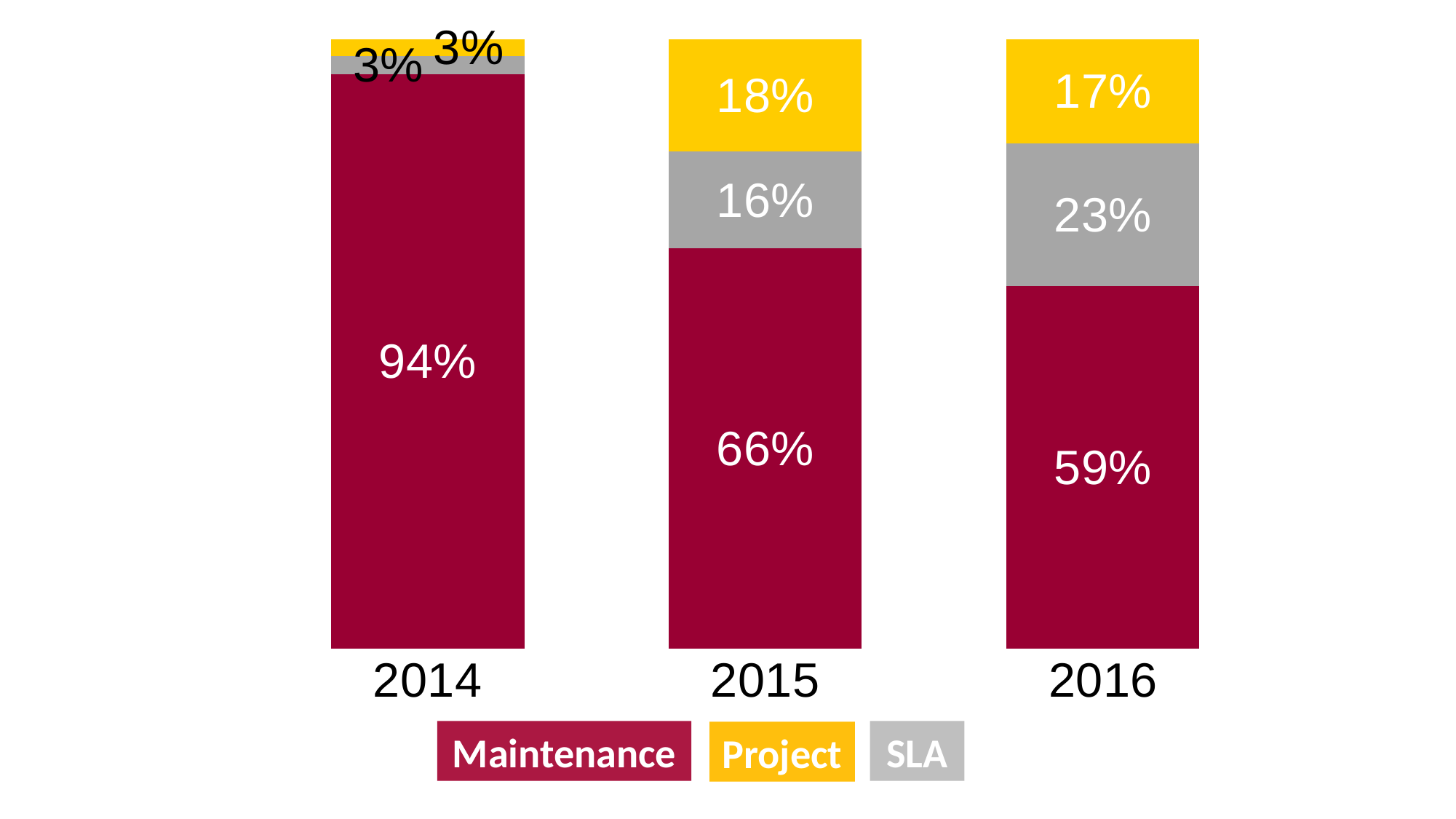
What is the Maintenance share in 2016? 59% How many series does the legend list? 3 By how many percentage points did the Maintenance share fall from 2014 to 2016? 35 What is the Maintenance share in 2014? 94% In which year is the SLA share lowest? 2014 What kind of chart is shown on the slide? Stacked bar chart How many years are shown on the x axis? 3 What is the SLA share in 2016? 23% What is the Project share in 2015? 18% In which year is the Maintenance share highest? 2014 In 2016, which is larger, the Project share or the SLA share? SLA Does the Maintenance share rise or fall from 2014 to 2016? Fall